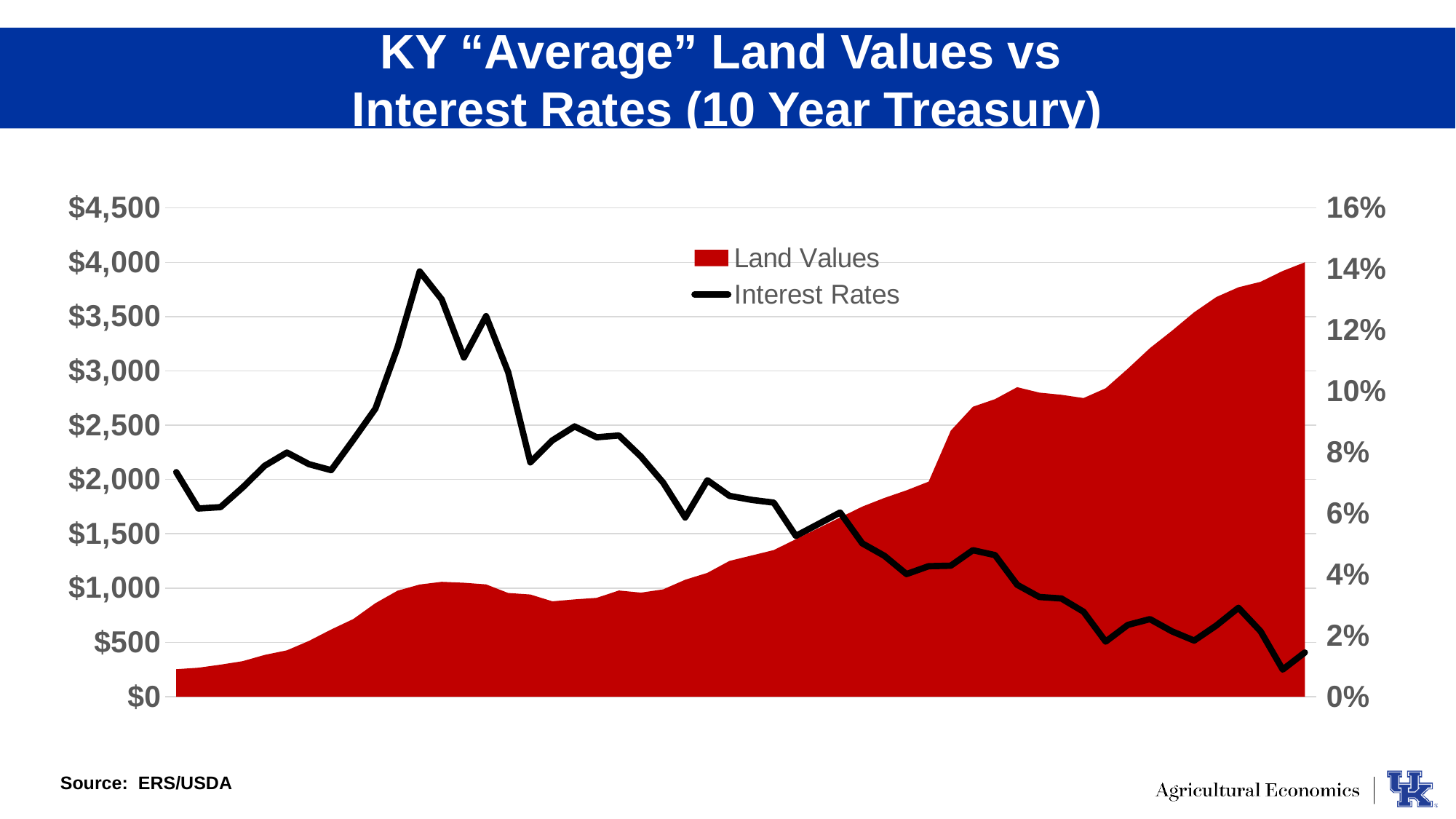
Is the Interest Rate at the right end of the chart greater or less than 2%? less What colour is used for the Land Values series? Red Is the highest point of the Interest Rates line greater or less than 12%? greater What kind of chart is shown on the slide? A combination chart with a filled area (Land Values) and a line (Interest Rates) How many series does the legend list? 2 Is the Interest Rate at the left end of the chart greater or less than 6%? greater Do the Land Values generally rise or fall from left to right along the x axis? Rise What is the highest value shown on the right-hand (percentage) axis? 16% Comparing the left end to the right end of the chart, do the Interest Rates end higher or lower than they started? Lower Which is larger: the Land Value at the left end of the chart or the Land Value at the right end? The right end